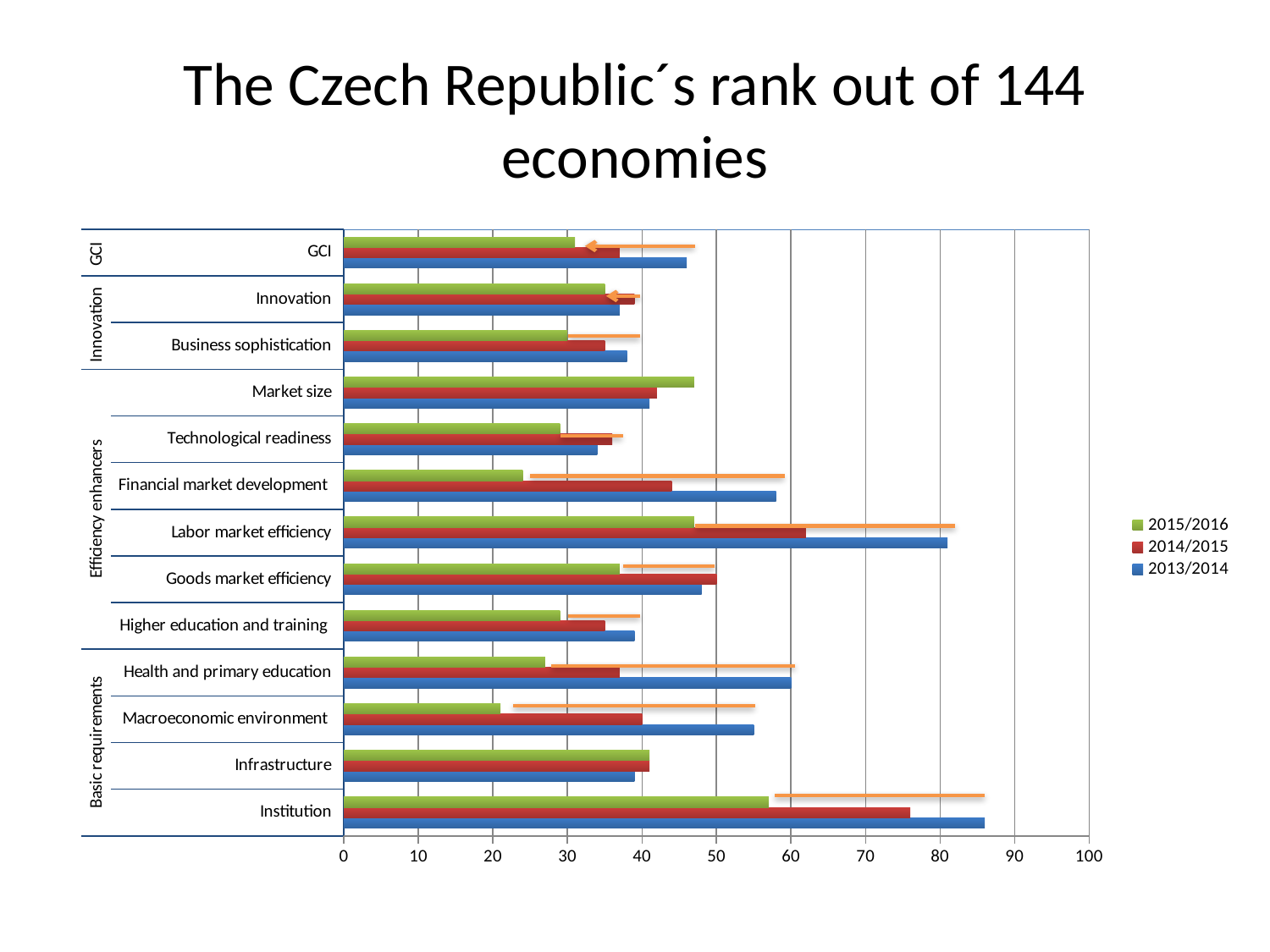
How many categories are plotted on the chart? 13 Is the 2013/2014 value for Institution greater or less than 80? greater Which category has the highest 2013/2014 value? Institution How many series does the legend list? 3 For Institution, which series has the larger value: 2015/2016 or 2013/2014? 2013/2014 Is the 2014/2015 value for Labor market efficiency greater or less than 50? greater Is the 2015/2016 value for Macroeconomic environment greater or less than 30? less Which category has the highest 2015/2016 value? Institution Which category has the highest 2014/2015 value? Institution For Market size, which series has the larger value: 2015/2016 or 2013/2014? 2015/2016 What kind of chart is shown on the slide? bar chart What is the title of the slide's chart? The Czech Republic´s rank out of 144 economies